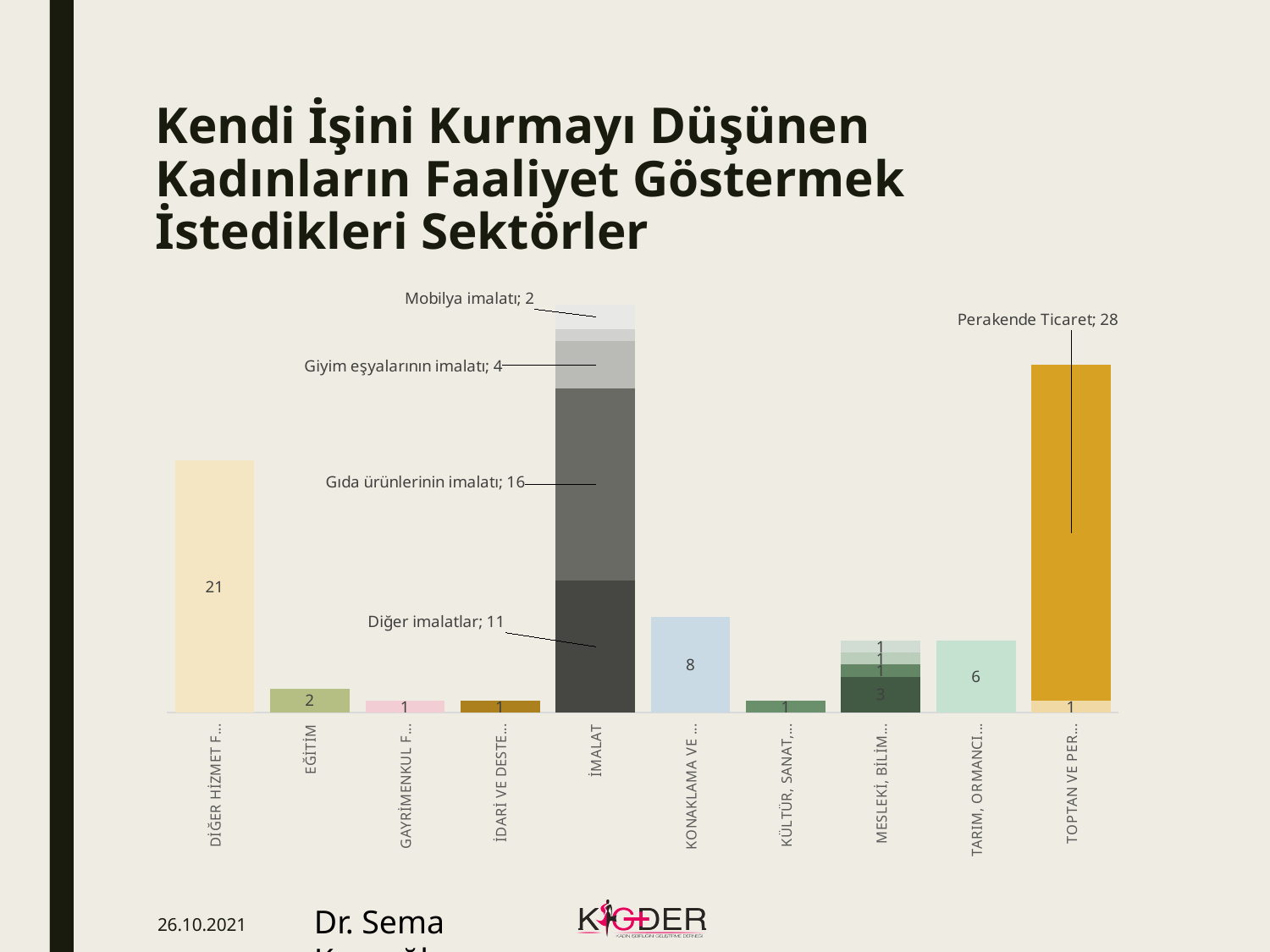
What is the value of the Perakende Ticaret segment? 28 What is the value for EĞİTİM? 2 What is the total of the stacked bar for TOPTAN VE PER...? 29 Which category has the tallest bar? İMALAT What is the difference between the Gıda ürünlerinin imalatı segment and the Giyim eşyalarının imalatı segment? 12 What is the value of the Gıda ürünlerinin imalatı segment in the İMALAT bar? 16 What is the value of the Diğer imalatlar segment? 11 What is the value of the Mobilya imalatı segment? 2 What kind of chart is shown on the slide? bar chart Which is larger, the value for DİĞER HİZMET F... or the value for TARIM, ORMANCI...? DİĞER HİZMET F... How many categories are shown on the x axis? 10 What is the value for the KONAKLAMA VE ... category? 8